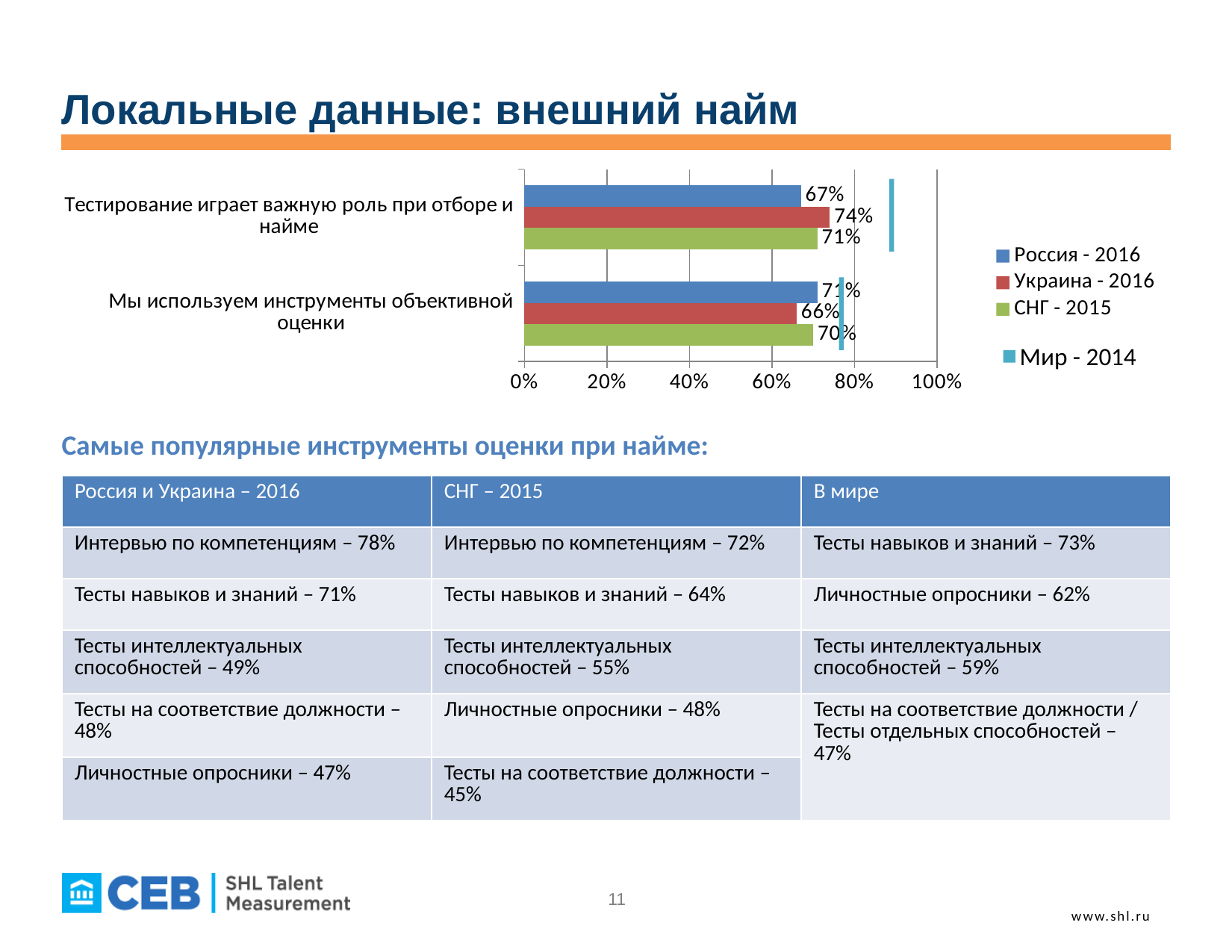
How many series does the chart legend list? 4 Which series has the highest value for 'Тестирование играет важную роль при отборе и найме' among the labelled bars? Украина - 2016 What is the value for Украина - 2016 for 'Тестирование играет важную роль при отборе и найме'? 74% Is the Мир - 2014 value for 'Тестирование играет важную роль при отборе и найме' greater or less than 80%? greater What is the difference between the Украина - 2016 and Россия - 2016 values for 'Тестирование играет важную роль при отборе и найме'? 7% Which series has the lowest value for 'Мы используем инструменты объективной оценки' among the labelled bars? Украина - 2016 Which is larger for Россия - 2016: the value for 'Тестирование играет важную роль при отборе и найме' or for 'Мы используем инструменты объективной оценки'? Мы используем инструменты объективной оценки What type of chart is shown on the slide? bar chart What is the value for СНГ - 2015 for 'Мы используем инструменты объективной оценки'? 70% How many categories are shown on the chart's vertical axis? 2 What is the value for Россия - 2016 for 'Тестирование играет важную роль при отборе и найме'? 67% What is the value for Украина - 2016 for 'Мы используем инструменты объективной оценки'? 66%